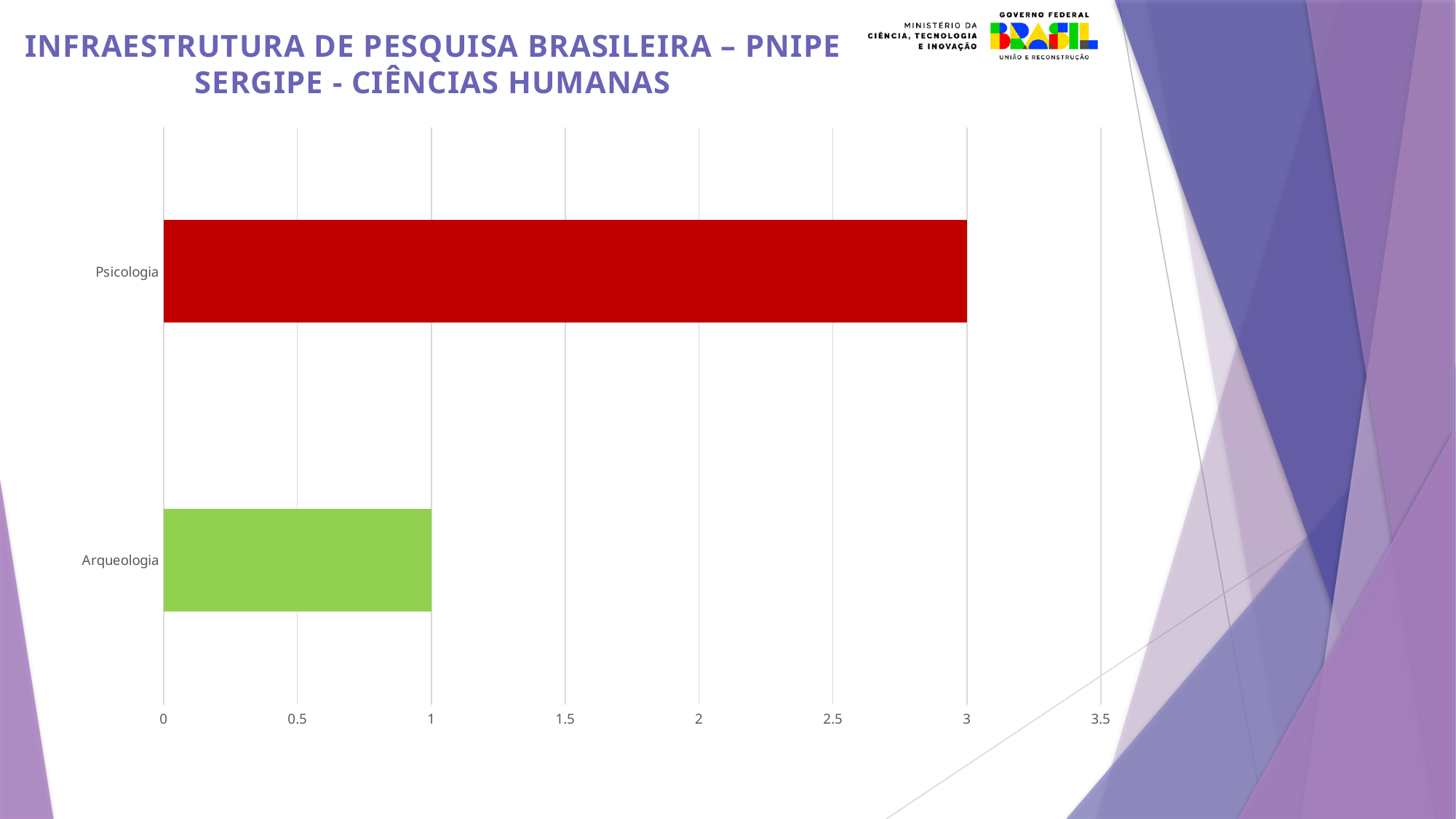
Is the value for Arqueologia greater or less than 2? less Which category has the lowest value? Arqueologia Which is larger, the value for Psicologia or the value for Arqueologia? Psicologia Which category has the highest value? Psicologia What is the difference between the values for Psicologia and Arqueologia? 2 How many categories are shown in the chart? 2 Is the value for Psicologia greater or less than 2? greater What is the value for Arqueologia? 1 What is the value for Psicologia? 3 What colour is the bar for Arqueologia? green What is the highest value shown on the x axis? 3.5 What kind of chart is shown on the slide? bar chart